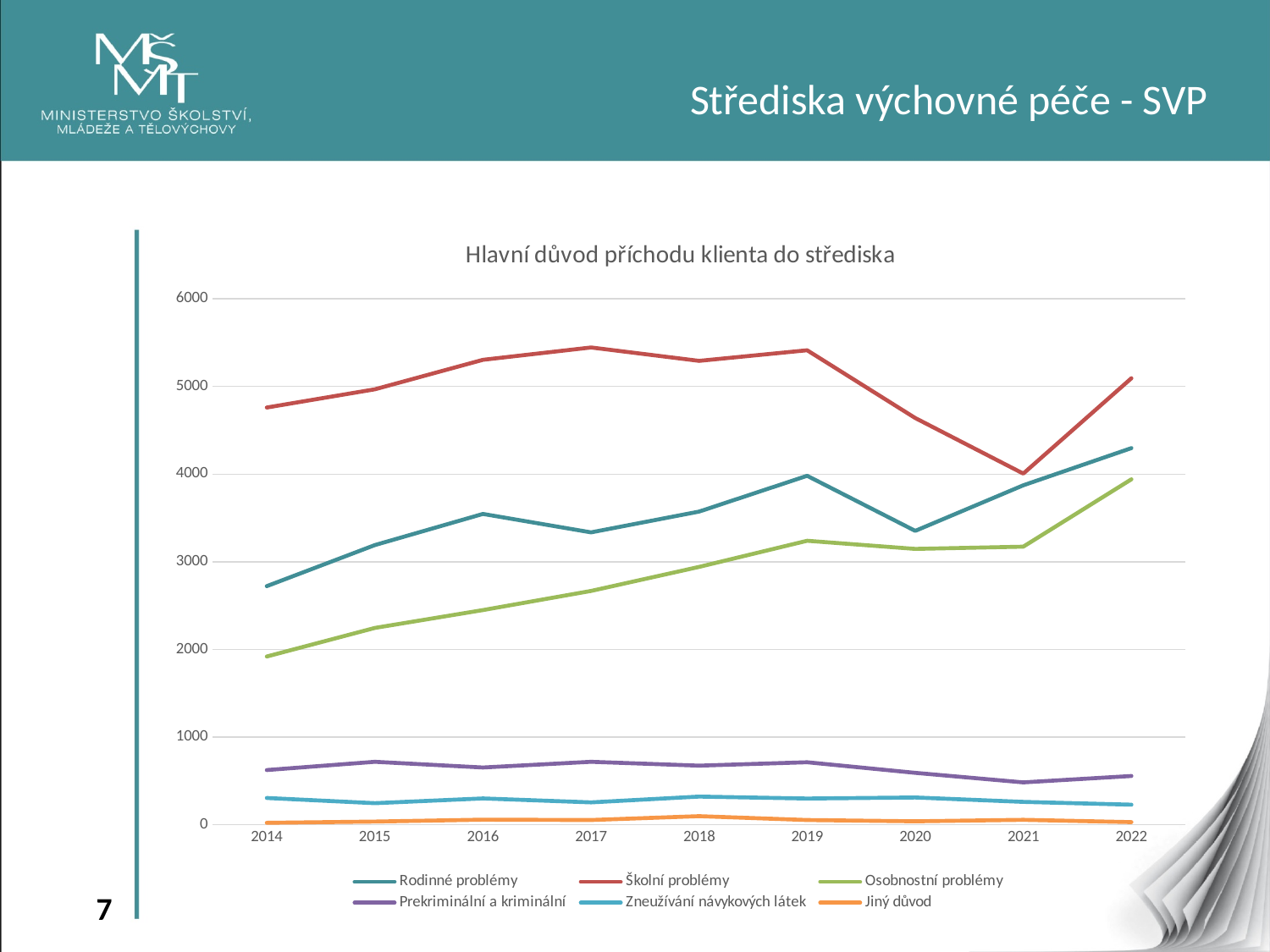
Is the value for Rodinné problémy in 2014 greater or less than 3000? less Do the values for Osobnostní problémy rise or fall from 2014 to 2019? rise What kind of chart is shown on the slide? line chart How many years are shown on the x axis? 9 Is the value for Školní problémy in 2017 greater or less than 5000? greater Which is larger for Rodinné problémy: the value in 2019 or in 2020? 2019 Which series has the lowest value in 2018? Jiný důvod Is the value for Prekriminální a kriminální in 2015 greater or less than 1000? less Do the values for Školní problémy rise or fall from 2019 to 2021? fall How many series does the legend list? 6 What is the title of the chart? Hlavní důvod příchodu klienta do střediska Which series has the highest value in 2017? Školní problémy